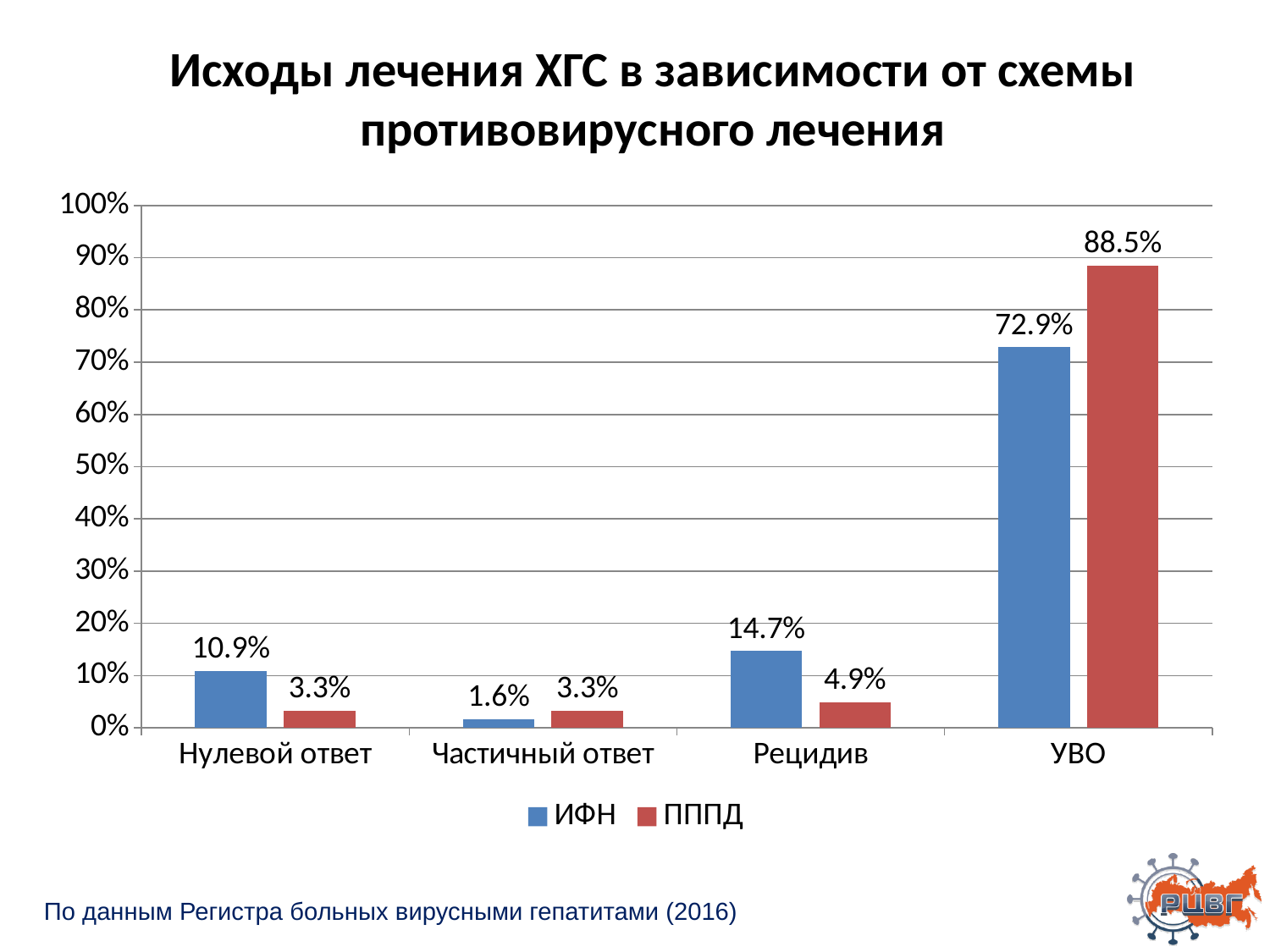
What is the value for ИФН in the Рецидив category? 14.7% In the Рецидив category, which series has the larger value, ИФН or ПППД? ИФН What kind of chart is shown on the slide? Bar chart How many series does the legend list? 2 What is the value for ИФН in the Нулевой ответ category? 10.9% Which category has the lowest value for the ПППД series? Нулевой ответ and Частичный ответ (both 3.3%) What colour represents the ПППД series? Red Which category has the highest value for the ИФН series? УВО How many categories are shown on the x axis? 4 What is the difference between the ПППД and ИФН values in the УВО category? 15.6% What is the value for ПППД in the Частичный ответ category? 3.3% What is the value for ПППД in the УВО category? 88.5%